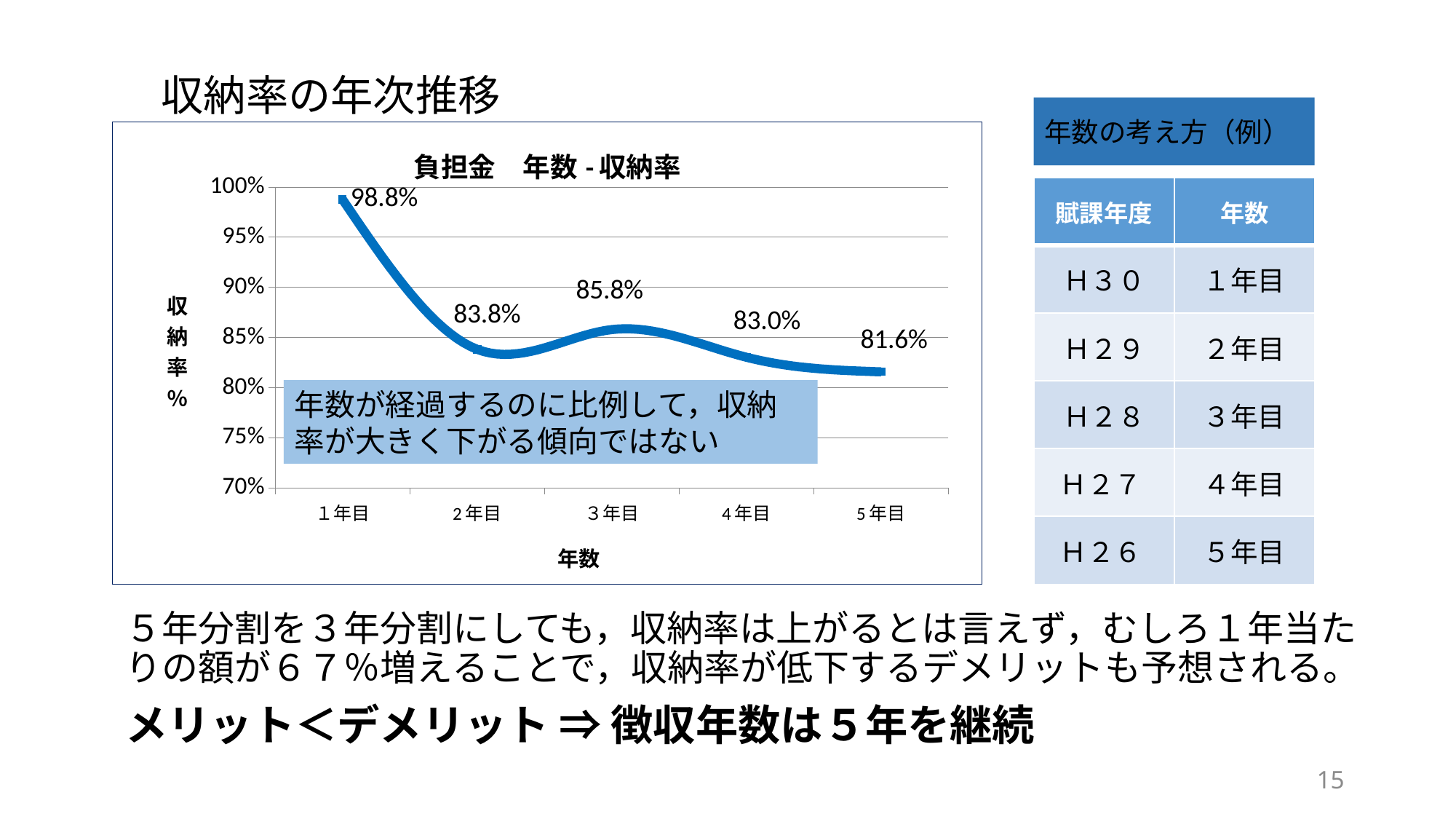
What is the difference between the collection rate in 1年目 and 2年目? 15.0% Which year has the lowest collection rate? 5年目 What is the collection rate for 5年目? 81.6% Is the value for 2年目 greater or less than 85%? less How many years (data points) are plotted on the x axis? 5 What is the collection rate (収納率) for 1年目? 98.8% Does the collection rate overall rise or fall from 1年目 to 5年目? fall What is the title of the chart? 負担金 年数 - 収納率 What kind of chart is shown? line chart What is the collection rate for 3年目? 85.8% Which is larger, the collection rate for 3年目 or 4年目? 3年目 Which year has the highest collection rate? 1年目